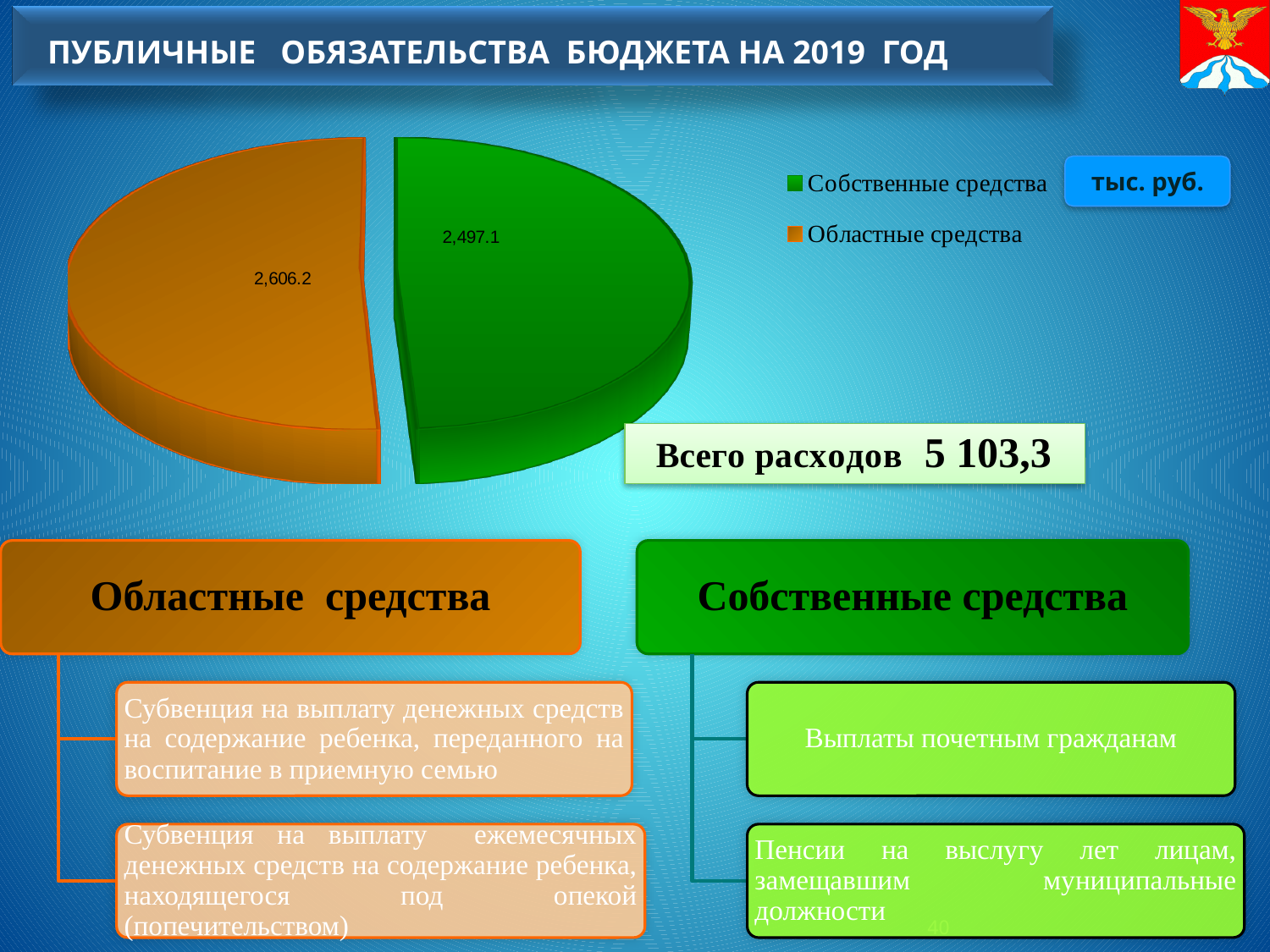
What colour is the Областные средства slice in the pie chart? orange In what units are the chart values given, according to the label next to the legend? тыс. руб. What kind of chart is shown on the slide? pie chart What is the difference between Областные средства and Собственные средства? 109.1 Which slice of the pie chart is the largest? Областные средства Which is larger, Областные средства or Собственные средства? Областные средства What is the value for Собственные средства in the pie chart? 2,497.1 What is the value for Областные средства in the pie chart? 2,606.2 What total expenditure (Всего расходов) is shown next to the chart? 5 103,3 How many entries does the chart legend list? 2 Which slice of the pie chart is the smallest? Собственные средства How many slices does the pie chart have? 2